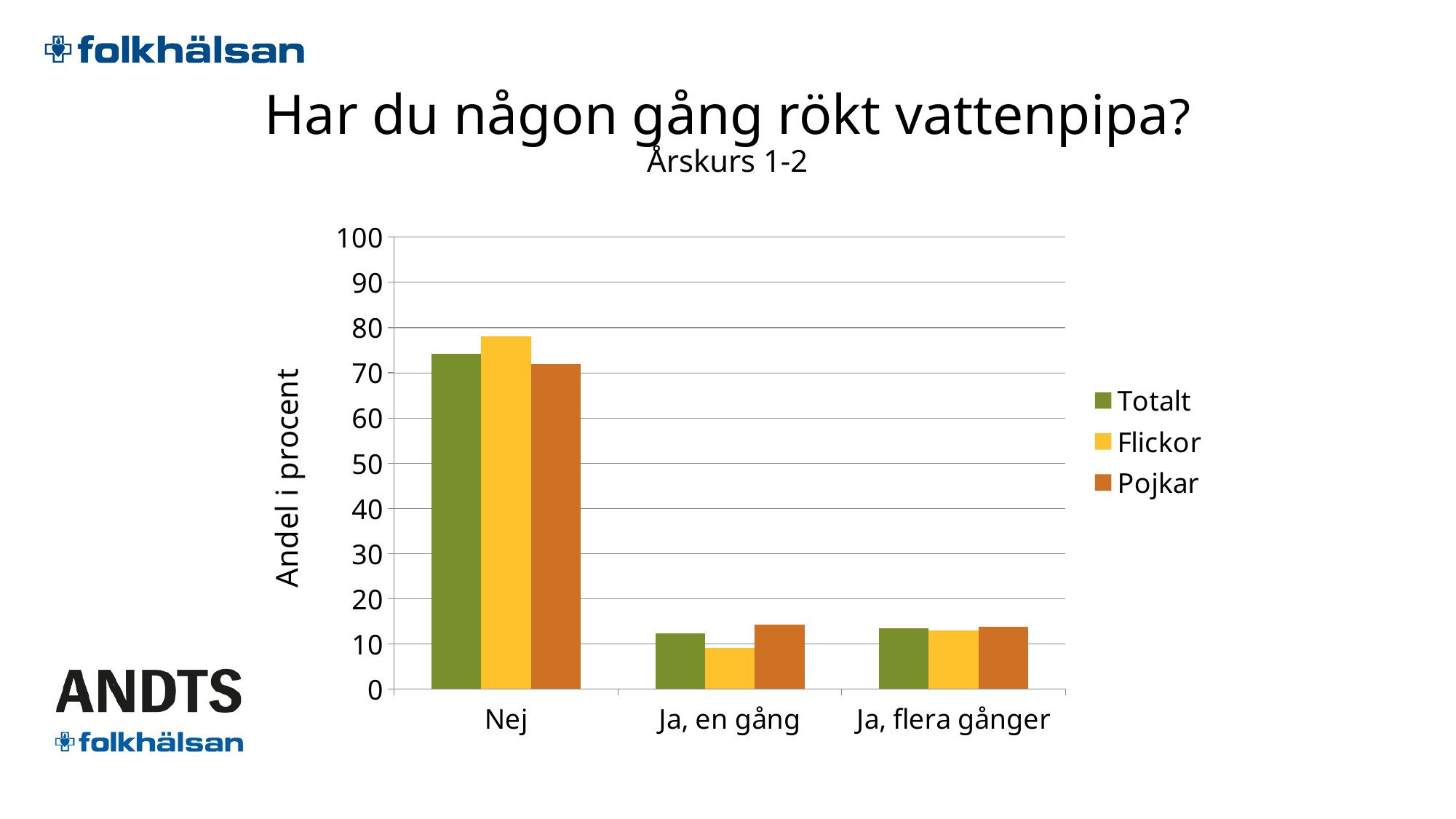
Which series has the lowest value in the Ja, en gång category? Flickor How many categories are shown on the x axis of the chart? 3 Is the value for Flickor in the Nej category greater or less than 70? greater In the Nej category, which is larger: Flickor or Pojkar? Flickor Which series has the highest value in the Nej category? Flickor Which category has the lowest value for the Flickor series? Ja, en gång What kind of chart is shown on the slide? bar chart Is the value for Totalt in the Ja, en gång category greater or less than 20? less Which category has the highest value for the Totalt series? Nej In the Ja, en gång category, which is larger: Flickor or Pojkar? Pojkar What is the label of the vertical axis of the chart? Andel i procent How many series does the chart's legend list? 3